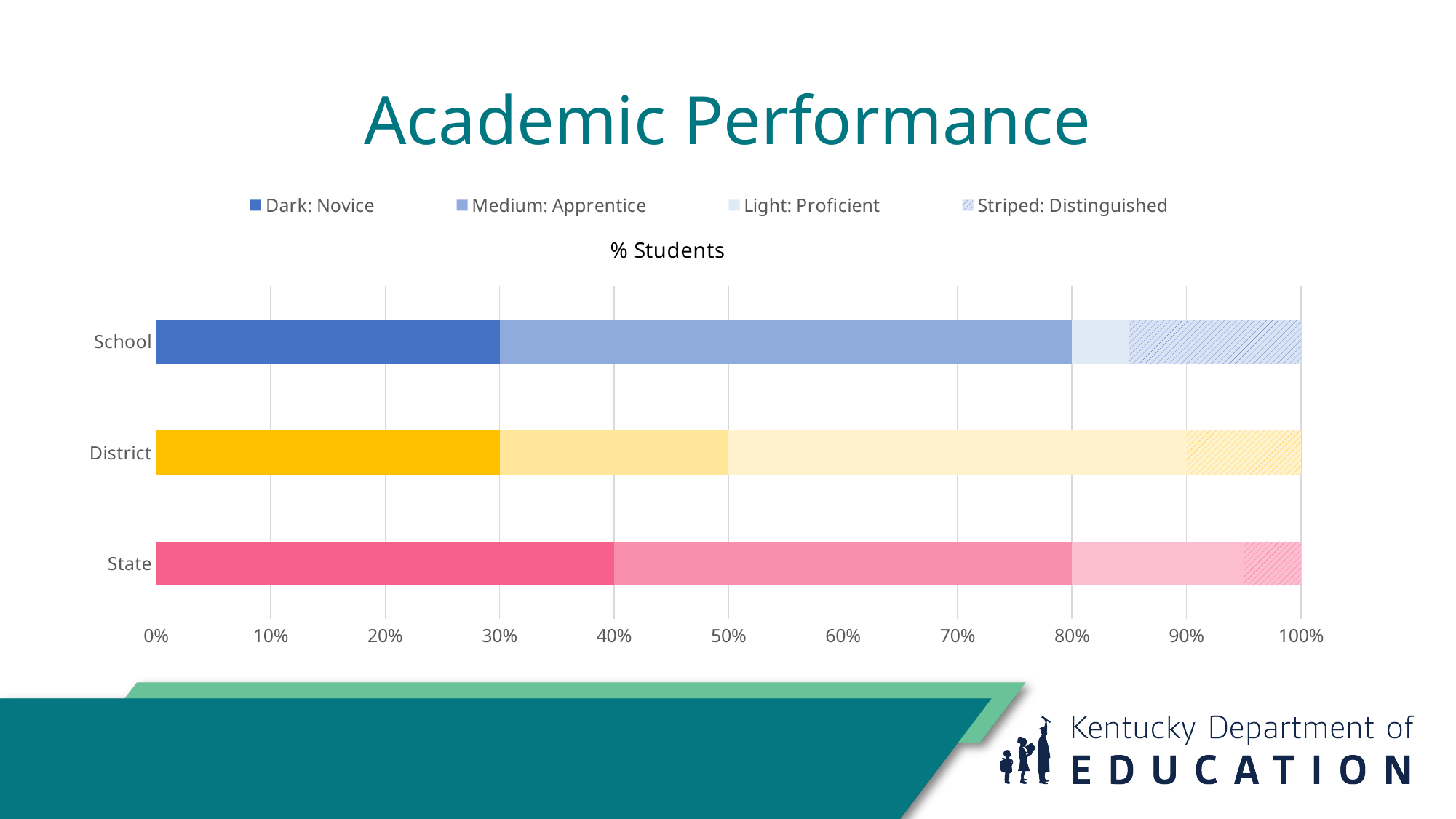
Which is larger, the Novice percentage for School or for State? State Is the Distinguished percentage for State greater or less than 10%? less Which category has the highest Novice percentage? State How many series does the legend list? 4 Is the Proficient percentage for District greater or less than 30%? greater How many categories are plotted on the vertical axis? 3 Which is larger, the Apprentice percentage for School or for District? School What percentage of School students are Novice? 30% What is the title shown above the plot area of the chart? % Students What kind of chart is shown on the slide? bar chart What percentage of State students are Novice? 40% What percentage of District students are Apprentice? 20%